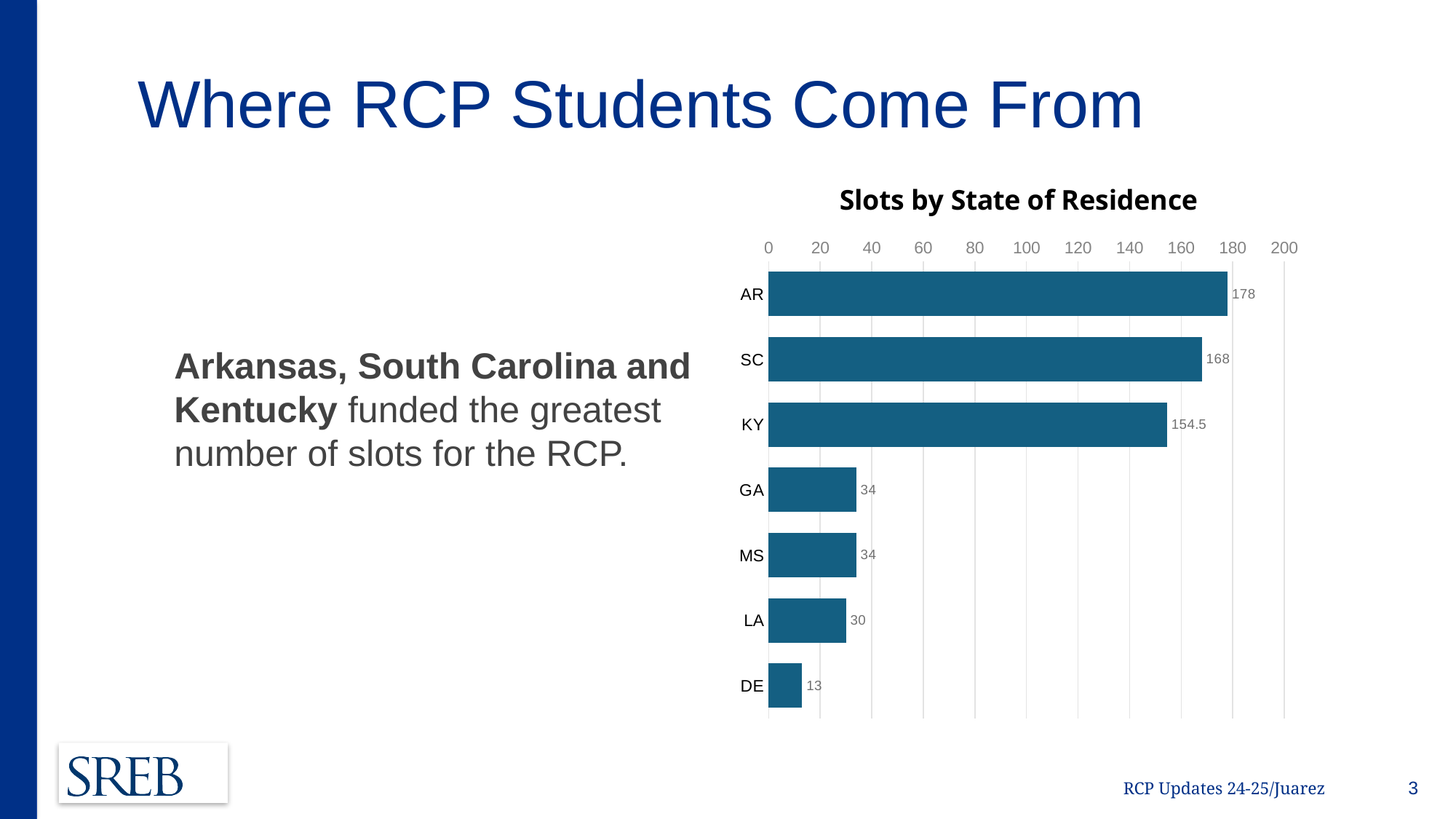
What is the difference between the slots for AR and SC? 10 What is the value for AR in the Slots by State of Residence chart? 178 Is the value for KY greater or less than 140? greater What is the value for KY in the Slots by State of Residence chart? 154.5 Which state has the highest number of slots? AR What kind of chart is shown on the slide? Bar chart What is the difference between the slots for LA and DE? 17 How many states are shown in the chart? 7 What is the value for DE in the Slots by State of Residence chart? 13 Which has more slots, SC or KY? SC What is the title of the chart? Slots by State of Residence Which state has the lowest number of slots? DE